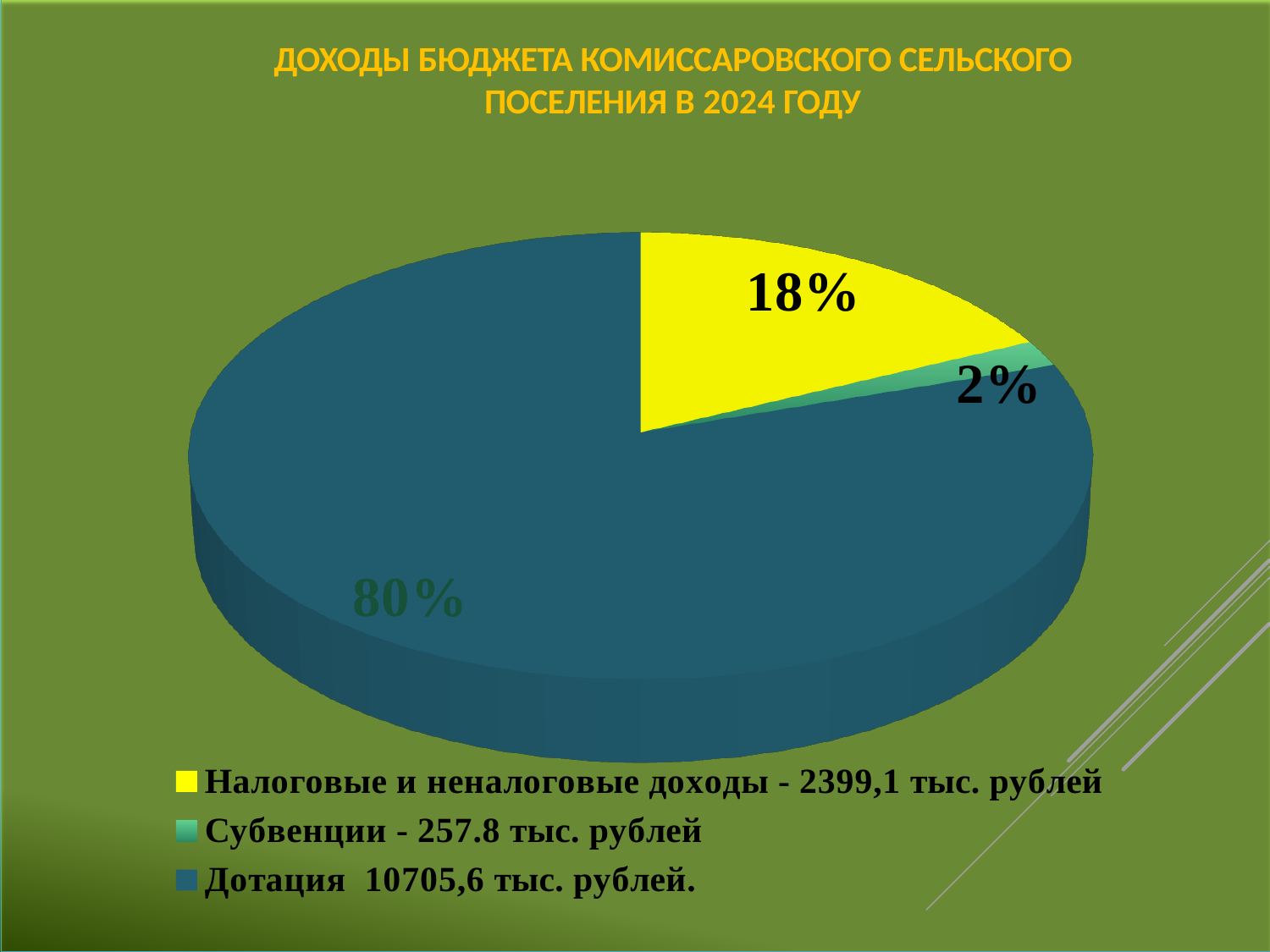
Which colour represents Субвенции in the pie chart? green Which category has the largest slice of the pie? Дотация What share of the pie does the Дотация slice represent? 80% What amount is given in the legend for Налоговые и неналоговые доходы? 2399,1 тыс. рублей What amount is given in the legend for Субвенции? 257.8 тыс. рублей By how many percentage points does the Дотация share exceed the Налоговые и неналоговые доходы share? 62 What amount is given in the legend for Дотация? 10705,6 тыс. рублей What kind of chart is shown on the slide? pie chart What share of the pie does the Субвенции slice represent? 2% What share of the pie does the Налоговые и неналоговые доходы slice represent? 18% How many slices does the pie chart have? 3 Which category has the smallest slice of the pie? Субвенции